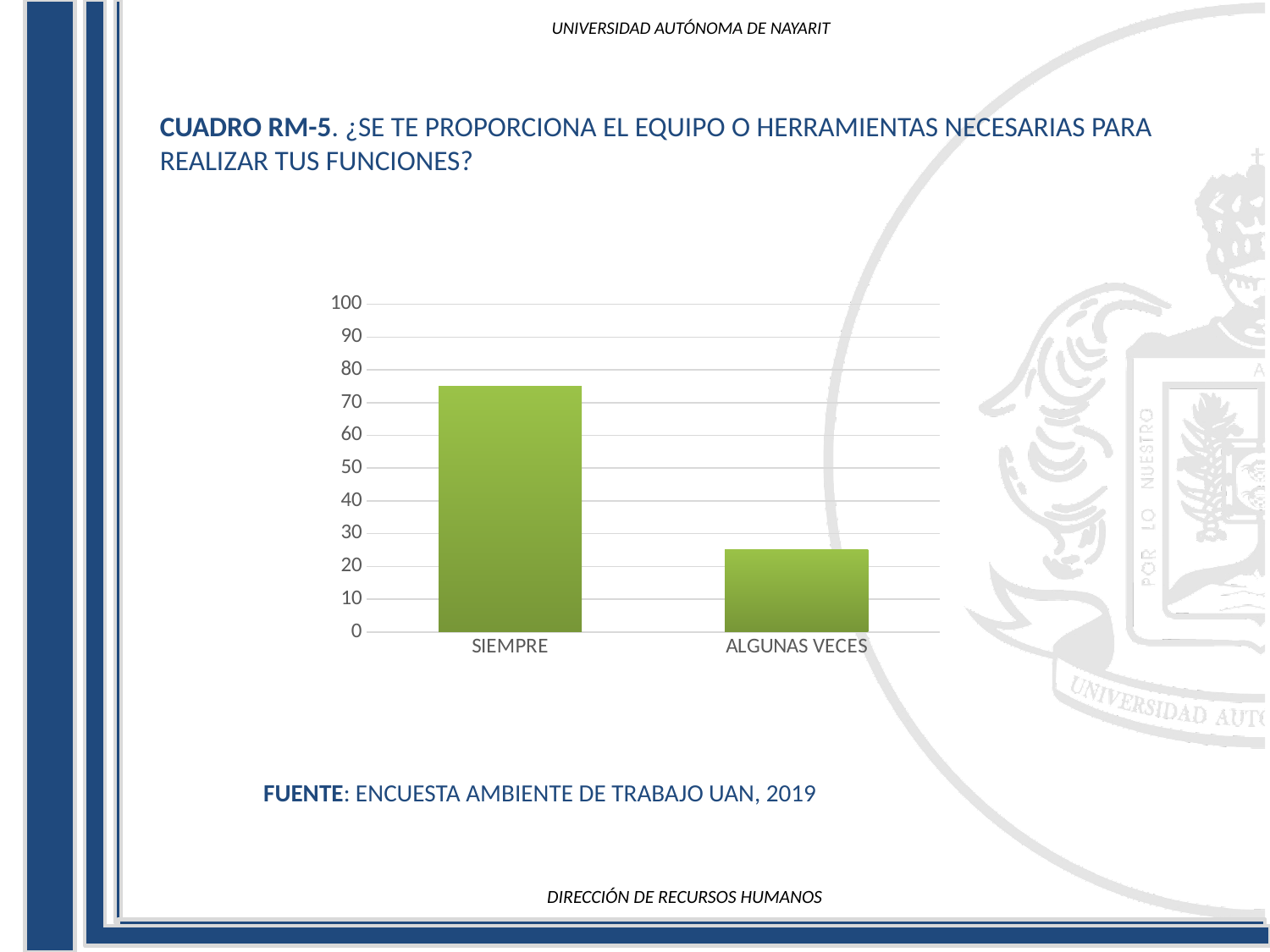
Is the value for ALGUNAS VECES greater or less than 20? greater What is the maximum value shown on the vertical axis of the chart? 100 What source is cited below the chart? ENCUESTA AMBIENTE DE TRABAJO UAN, 2019 How many categories are shown on the x axis of the chart? 2 Is the value for SIEMPRE greater or less than 50? greater Is the value for ALGUNAS VECES greater or less than 30? less Which is larger, the value for SIEMPRE or the value for ALGUNAS VECES? SIEMPRE Which category has the highest value in the chart? SIEMPRE Which category has the lowest value in the chart? ALGUNAS VECES What kind of chart is shown on the slide? bar chart